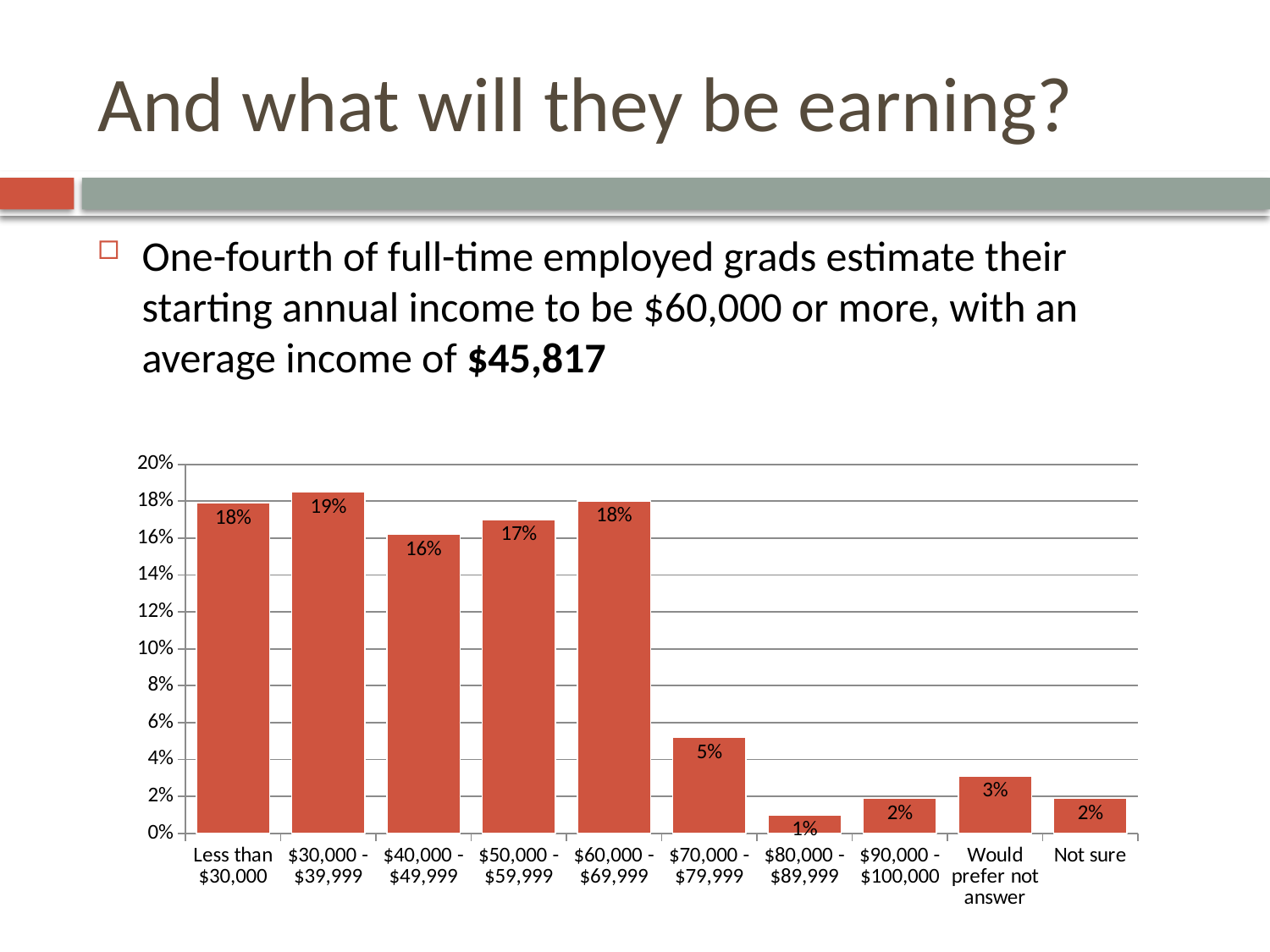
Which is larger, the value for $50,000 - $59,999 or the value for $40,000 - $49,999? $50,000 - $59,999 What is the difference between the values for $30,000 - $39,999 and $40,000 - $49,999? 3% What percentage of grads answered 'Would prefer not answer'? 3% How many categories are shown on the x axis of the chart? 10 What kind of chart is shown on the slide? bar chart Which income category has the highest percentage? $30,000 - $39,999 What is the difference between the values for $60,000 - $69,999 and $70,000 - $79,999? 13% Which income category has the lowest percentage? $80,000 - $89,999 What is the value shown for the $70,000 - $79,999 category? 5% Is the value for $70,000 - $79,999 greater or less than 10%? less What is the value for the $40,000 - $49,999 category? 16% What percentage of grads estimate a starting income of $30,000 - $39,999? 19%